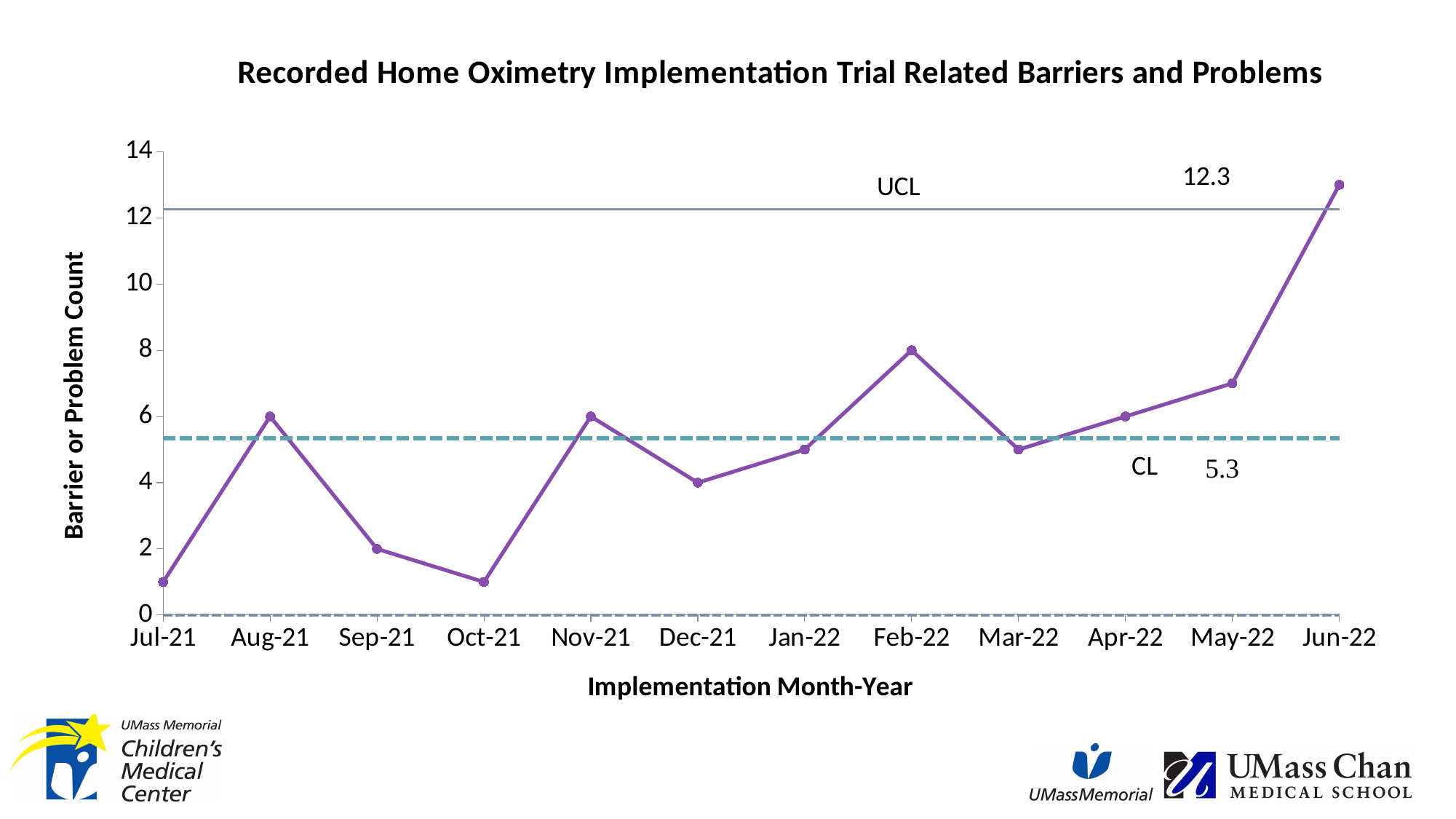
What is the value of the UCL line labelled on the chart? 12.3 What kind of chart is shown? line chart Which month has the highest barrier or problem count? Jun-22 What is the difference between the counts for Feb-22 and Dec-21? 4 How many months are plotted on the x axis? 12 What is the barrier or problem count for Sep-21? 2 Which month has a higher count, Aug-21 or Sep-21? Aug-21 Do the values rise or fall from Mar-22 to Jun-22? rise Is the value for Oct-21 greater or less than 2? less Is the value for Jun-22 greater or less than 12? greater What is the barrier or problem count for Feb-22? 8 What is the barrier or problem count for Dec-21? 4